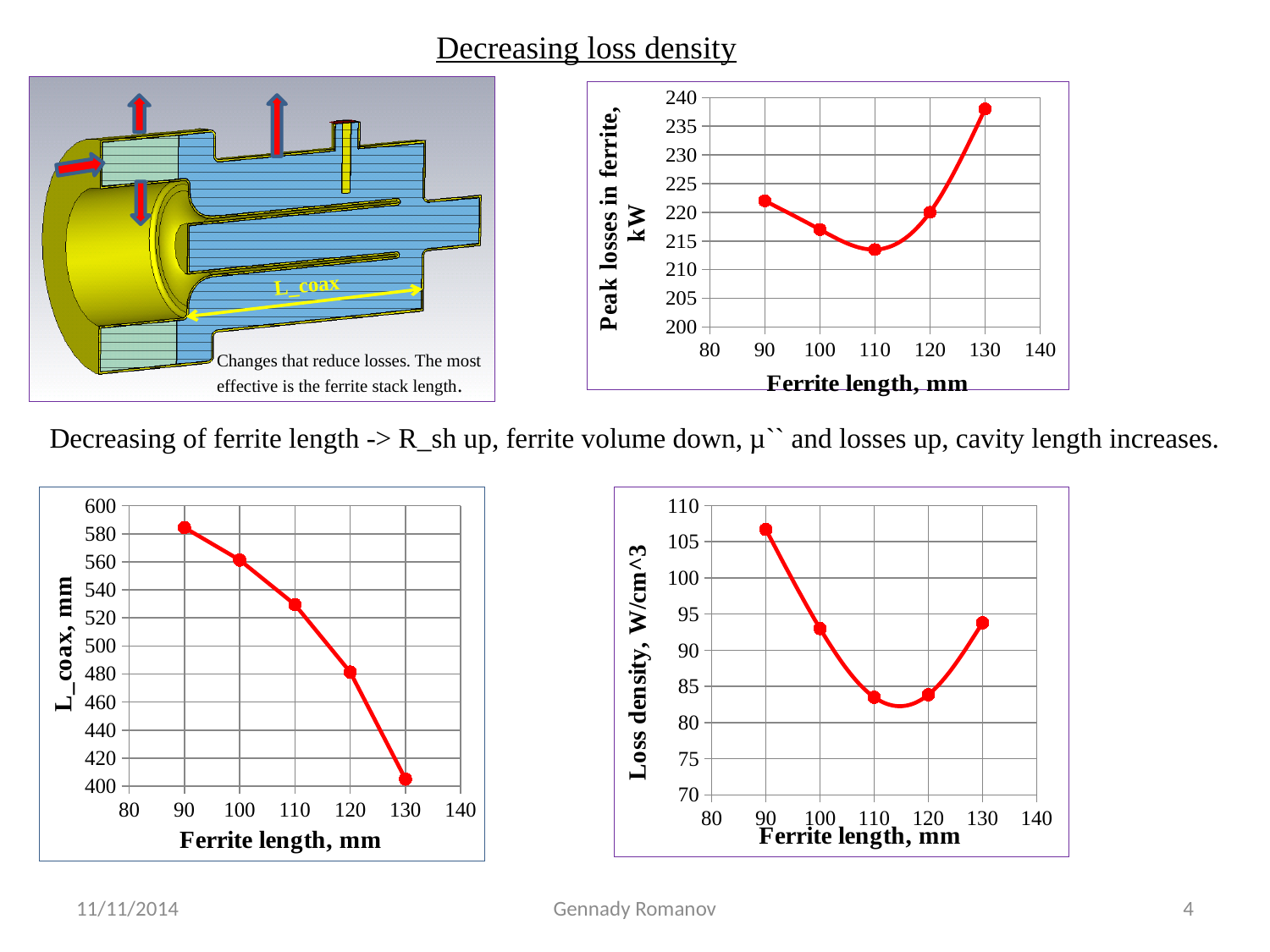
What kind of chart is the top-right chart with y-axis 'Peak losses in ferrite, kW'? line chart In the bottom-right chart (Loss density, W/cm^3), which has the larger loss density: ferrite length 90 or ferrite length 130? 90 In the top-right chart (Peak losses in ferrite, kW), is the value at ferrite length 110 greater or less than 215? less In the top-right chart (Peak losses in ferrite, kW), is the value at ferrite length 130 greater or less than 235? greater In the bottom-left chart (L_coax, mm), is the value at ferrite length 90 greater or less than 580? greater In the bottom-left chart (L_coax, mm), do the values rise or fall as ferrite length increases? fall What is the x-axis label of the bottom-right chart (Loss density, W/cm^3)? Ferrite length, mm In the top-right chart (Peak losses in ferrite, kW), how many data points are plotted? 5 In the bottom-right chart (Loss density, W/cm^3), at which ferrite length is the loss density highest? 90 In the top-right chart (Peak losses in ferrite, kW), at which ferrite length is the peak loss lowest? 110 In the top-right chart (Peak losses in ferrite, kW), at which ferrite length is the peak loss highest? 130